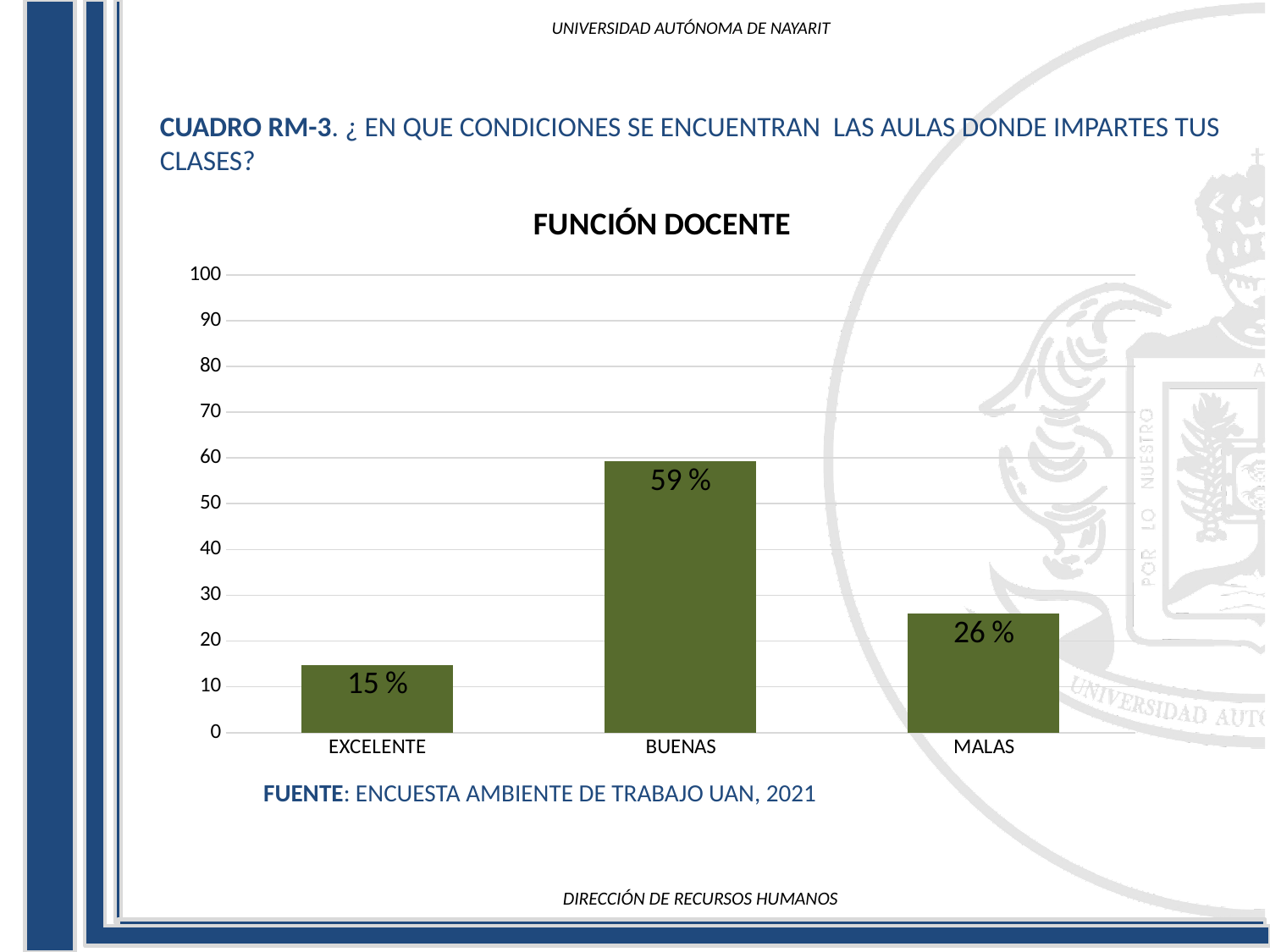
Which category has the lowest value? EXCELENTE What is the difference between the values for MALAS and EXCELENTE? 11 % Which is larger, the value for MALAS or the value for EXCELENTE? MALAS What is the difference between the values for BUENAS and MALAS? 33 % What is the value for BUENAS? 59 % What is the value for EXCELENTE? 15 % How many categories are shown on the x axis? 3 Is the value for BUENAS greater or less than 50? greater Which category has the highest value? BUENAS What is the title of the chart? FUNCIÓN DOCENTE What is the value for MALAS? 26 % What kind of chart is shown? bar chart